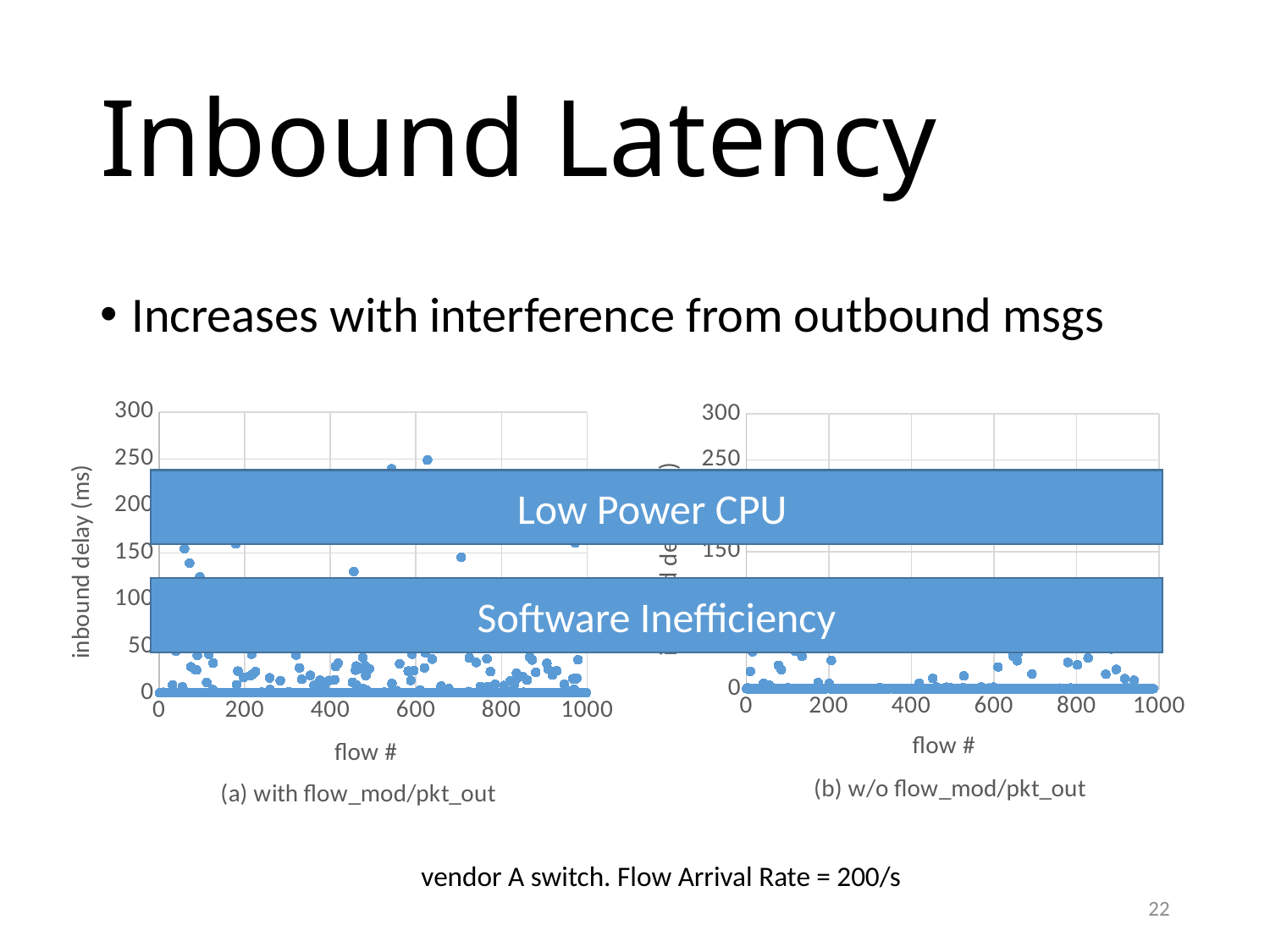
How many charts are shown on the slide? 2 In the chart "(a) with flow_mod/pkt_out", is the highest plotted inbound delay greater or less than 200? greater What is the y-axis label of the chart "(a) with flow_mod/pkt_out"? inbound delay (ms) What is the x-axis label of the chart "(a) with flow_mod/pkt_out"? flow # What kind of chart is the right chart, captioned "(b) w/o flow_mod/pkt_out"? scatter chart What kind of chart is the left chart, captioned "(a) with flow_mod/pkt_out"? scatter chart In the chart "(a) with flow_mod/pkt_out", is the highest plotted inbound delay greater or less than 300? less